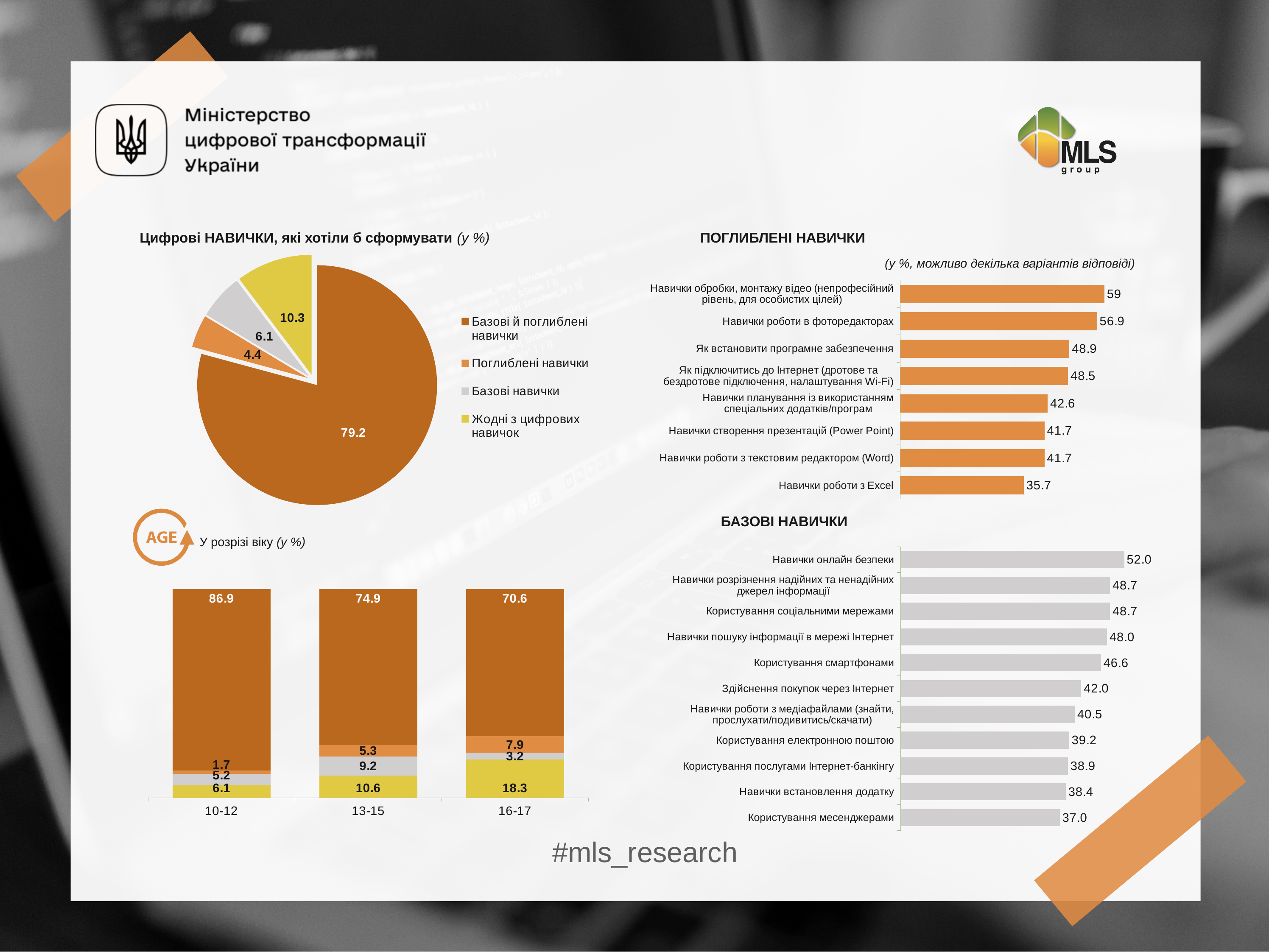
How many entries does the legend of the pie chart 'Цифрові НАВИЧКИ, які хотіли б сформувати' list? 4 In the stacked bar chart 'У розрізі віку', does the dark orange segment value rise or fall from 10-12 to 16-17? fall In the pie chart 'Цифрові НАВИЧКИ, які хотіли б сформувати', what is the value for 'Базові й поглиблені навички'? 79.2 In the stacked bar chart 'У розрізі віку', what is the difference between the top (dark orange) segment values for 10-12 and 16-17? 16.3 In the chart 'ПОГЛИБЛЕНІ НАВИЧКИ', which category has the highest value? Навички обробки, монтажу відео (непрофесійний рівень, для особистих цілей) How many categories are shown in the chart 'ПОГЛИБЛЕНІ НАВИЧКИ'? 8 What kind of chart is 'БАЗОВІ НАВИЧКИ'? bar chart In the stacked bar chart 'У розрізі віку', what is the value of the yellow segment for the 16-17 age group? 18.3 In the pie chart 'Цифрові НАВИЧКИ, які хотіли б сформувати', which category has the smallest slice? Поглиблені навички In the stacked bar chart 'У розрізі віку', how many age groups are shown on the x axis? 3 In the chart 'БАЗОВІ НАВИЧКИ', which is larger: 'Навички онлайн безпеки' or 'Користування месенджерами'? Навички онлайн безпеки In the chart 'ПОГЛИБЛЕНІ НАВИЧКИ', what is the value for 'Навички роботи з Excel'? 35.7